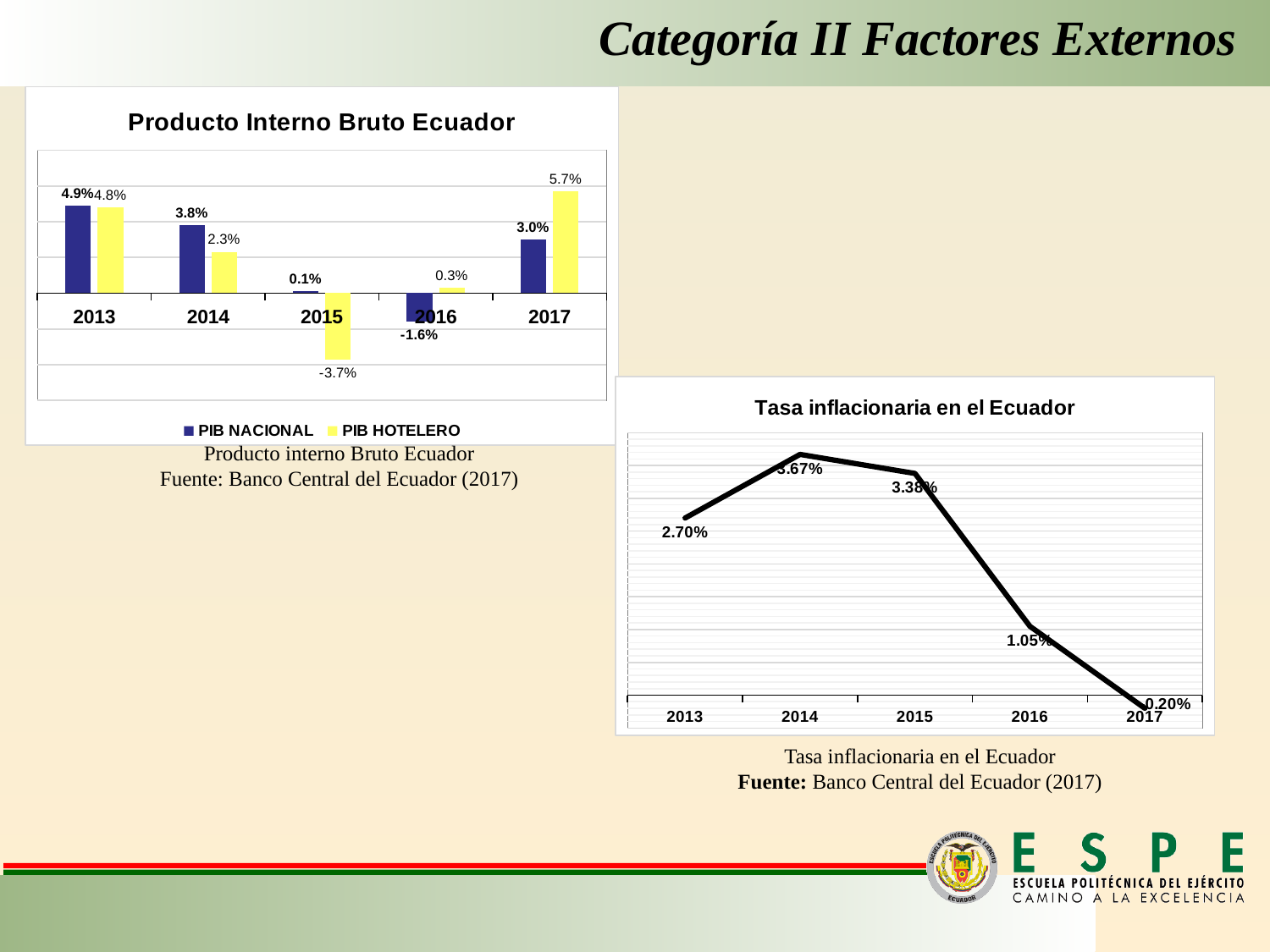
In the 'Producto Interno Bruto Ecuador' chart, what is the PIB HOTELERO value for 2015? -3.7% In the 'Producto Interno Bruto Ecuador' chart, what is the PIB NACIONAL value for 2014? 3.8% In the 'Producto Interno Bruto Ecuador' chart, what is the difference between PIB HOTELERO and PIB NACIONAL in 2017? 2.7% What kind of chart is 'Producto Interno Bruto Ecuador'? Bar chart In the 'Tasa inflacionaria en el Ecuador' chart, what is the value for 2016? 1.05% In the 'Producto Interno Bruto Ecuador' chart, which year has the lowest PIB NACIONAL value? 2016 In the 'Tasa inflacionaria en el Ecuador' chart, do the values rise or fall from 2014 to 2017? Fall In the 'Tasa inflacionaria en el Ecuador' chart, what is the difference between the 2013 and 2017 values? 2.90% In the 'Producto Interno Bruto Ecuador' chart, which is larger in 2014, PIB NACIONAL or PIB HOTELERO? PIB NACIONAL In the 'Producto Interno Bruto Ecuador' chart, which year has the highest PIB HOTELERO value? 2017 In the 'Tasa inflacionaria en el Ecuador' chart, which year has the highest inflation rate? 2014 How many series does the legend of the 'Producto Interno Bruto Ecuador' chart list? 2